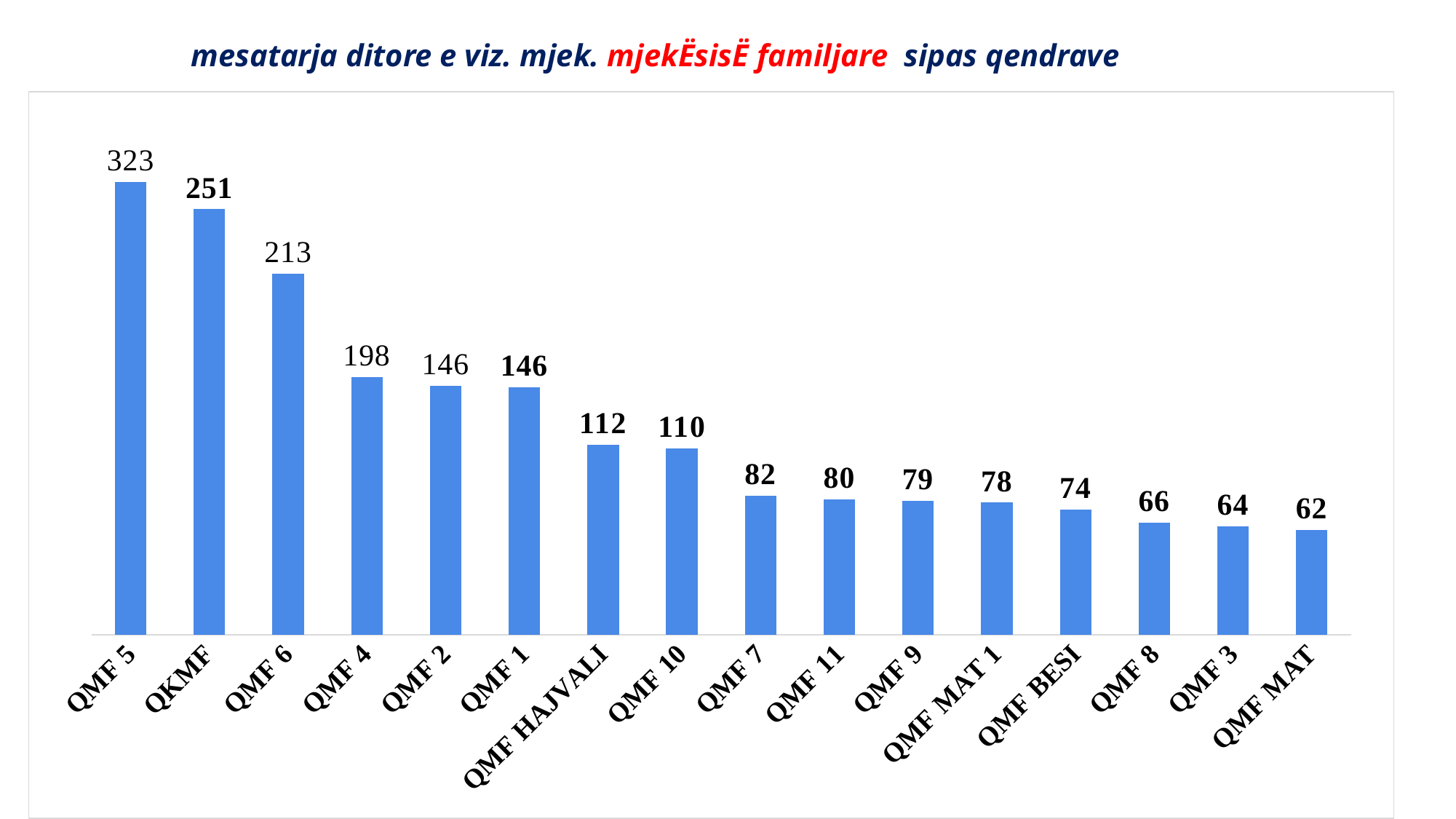
What is the value for QMF BESI? 74 Which is larger, the value for QMF 10 or the value for QMF 7? QMF 10 What is the value for QMF HAJVALI? 112 What is the value for QMF 5? 323 What is the difference between the values for QMF 5 and QKMF? 72 Which category has the highest value? QMF 5 Which category has the lowest value? QMF MAT What is the difference between the values for QMF 6 and QMF 4? 15 Which is larger, the value for QMF 8 or the value for QMF 3? QMF 8 Do the values rise or fall from left to right along the x axis? fall What kind of chart is this? bar chart How many categories are shown on the x axis? 16